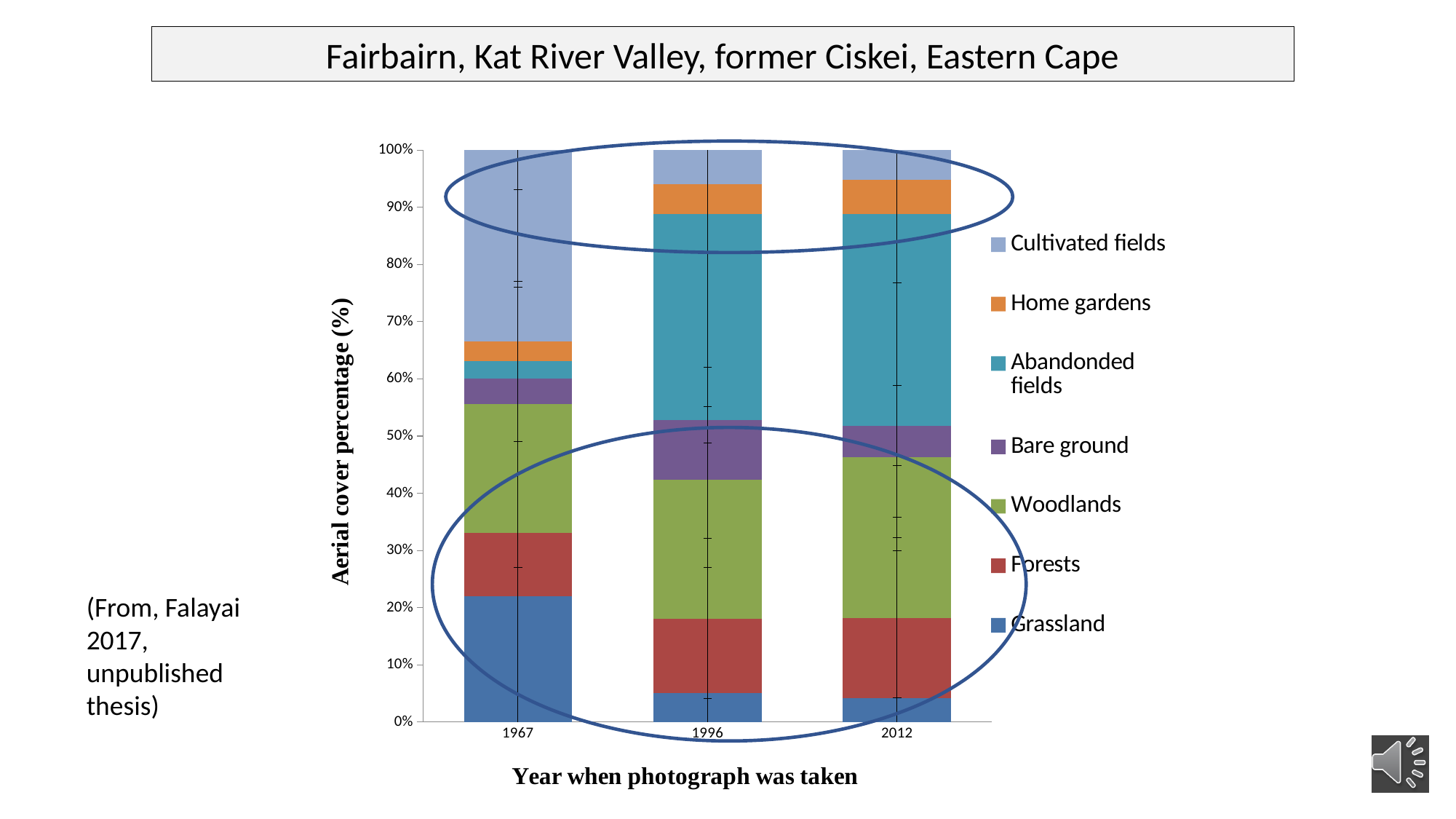
What is the title of the x axis? Year when photograph was taken Is the Grassland share in 1996 greater or less than 10%? less Which is larger: the Abandonded fields share in 1967 or in 1996? 1996 Which year has the largest Cultivated fields share? 1967 How many series does the legend list? 7 Which year has the largest Grassland share? 1967 Is the Abandonded fields share in 1996 greater or less than 30%? greater How many years (categories) are plotted on the x axis? 3 What is the title of the y axis? Aerial cover percentage (%) Does the Grassland share rise or fall from 1967 to 2012? fall Is the Grassland share in 1967 greater or less than 10%? greater What kind of chart is shown on the slide? Stacked bar chart